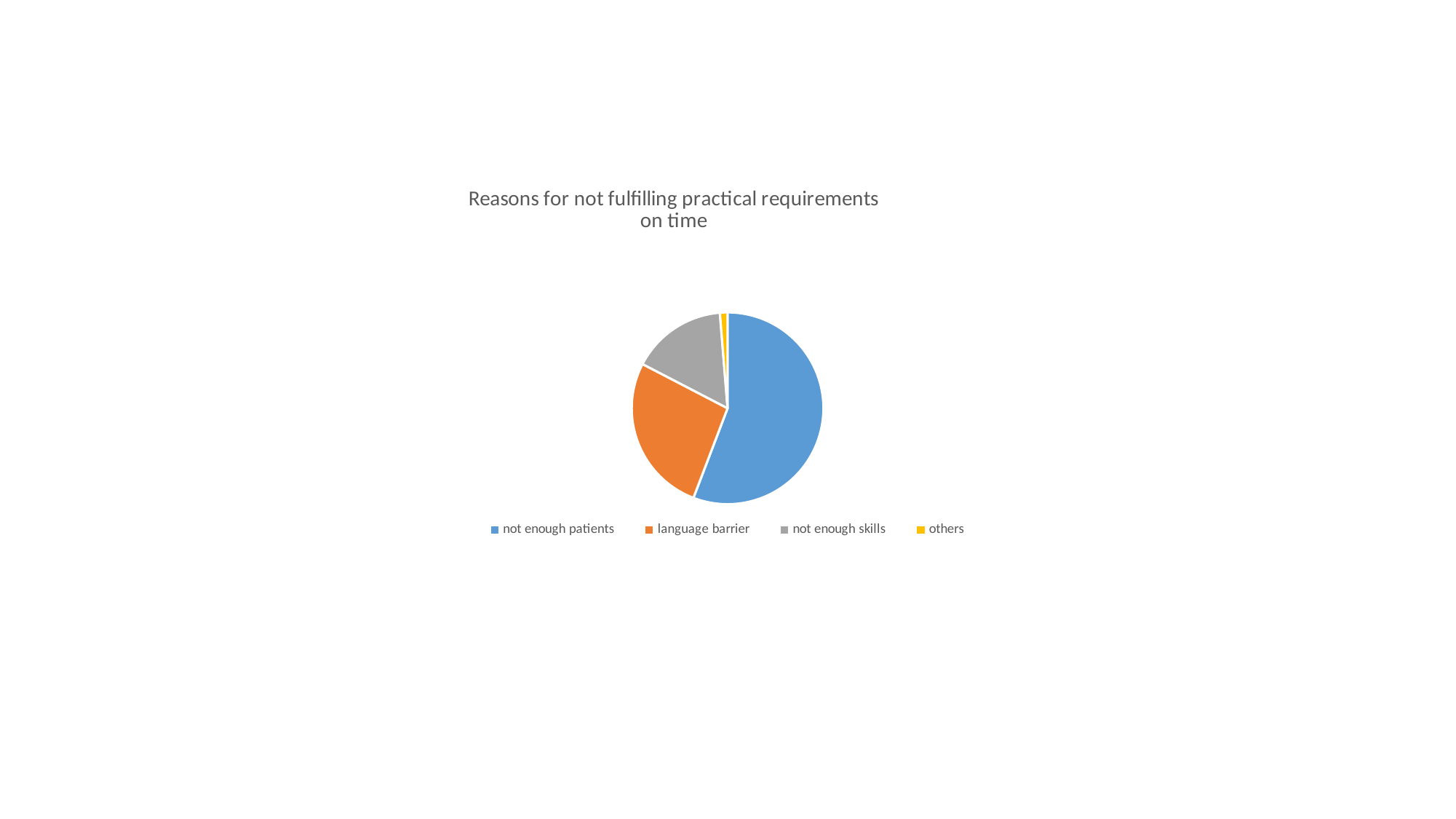
Which category has the largest slice of the pie? not enough patients Which slice is larger, not enough skills or others? not enough skills Which slice is larger, language barrier or not enough skills? language barrier Does the 'not enough patients' slice take up more or less than half of the pie? more Which slice is larger, not enough patients or language barrier? not enough patients Which category has the smallest slice of the pie? others Which colour represents the 'language barrier' category? orange How many categories does the legend list? 4 What is the title of the chart? Reasons for not fulfilling practical requirements on time What kind of chart is shown on the slide? pie chart